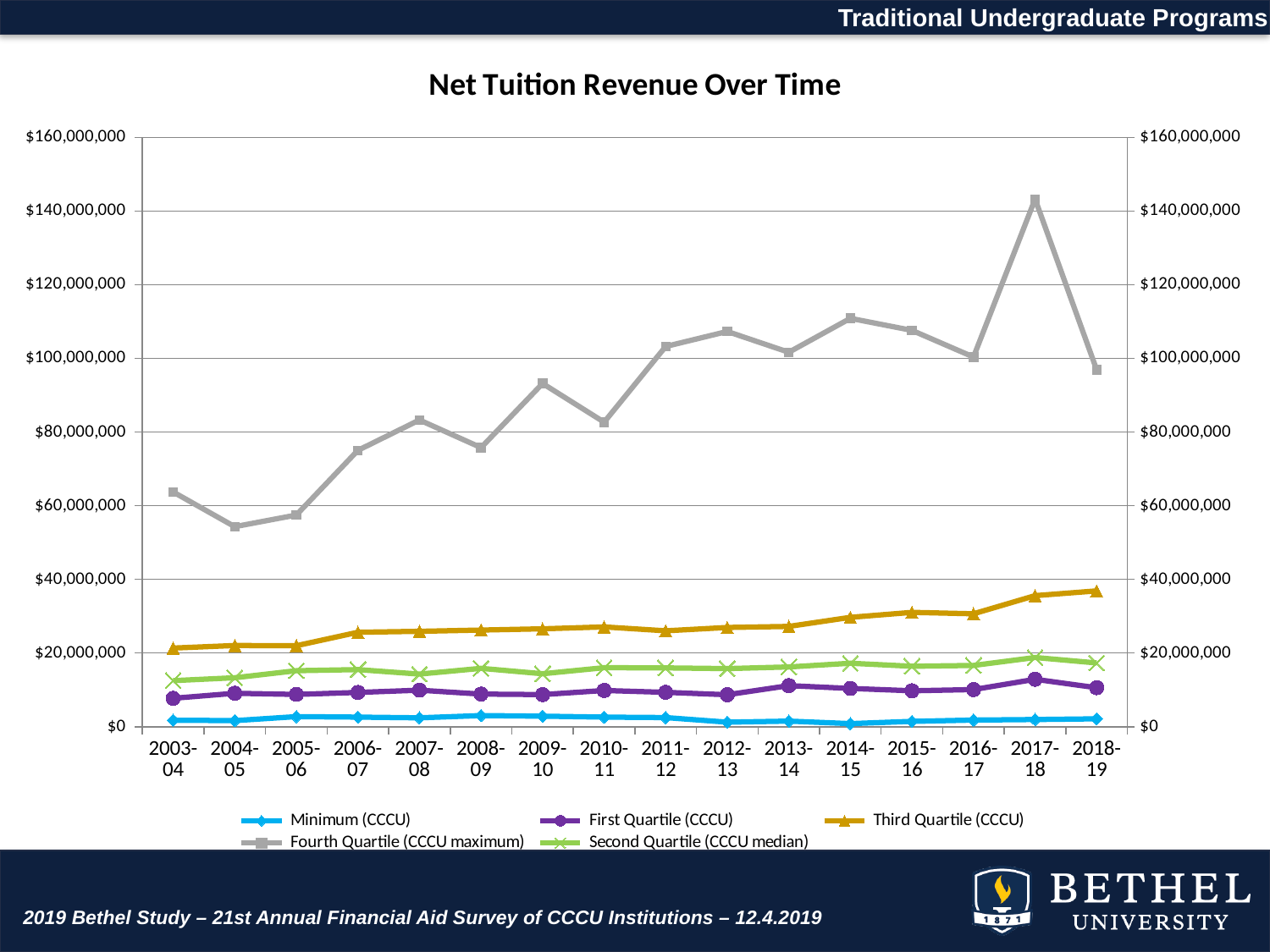
Which is larger for the Fourth Quartile (CCCU maximum) series: the value for 2010-11 or the value for 2011-12? 2011-12 Is the Fourth Quartile (CCCU maximum) value for 2004-05 greater or less than $60,000,000? less In which year is the Fourth Quartile (CCCU maximum) series at its lowest value? 2004-05 Is the Second Quartile (CCCU median) value for 2003-04 greater or less than $20,000,000? less How many series does the legend list? 5 What kind of chart is shown on the slide? line chart How many academic years are plotted along the x axis? 16 What is the title of the chart? Net Tuition Revenue Over Time Does the Third Quartile (CCCU) series generally rise or fall from 2003-04 to 2018-19? rise Is the Third Quartile (CCCU) value for 2018-19 greater or less than $40,000,000? less In which year does the Fourth Quartile (CCCU maximum) series reach its highest value? 2017-18